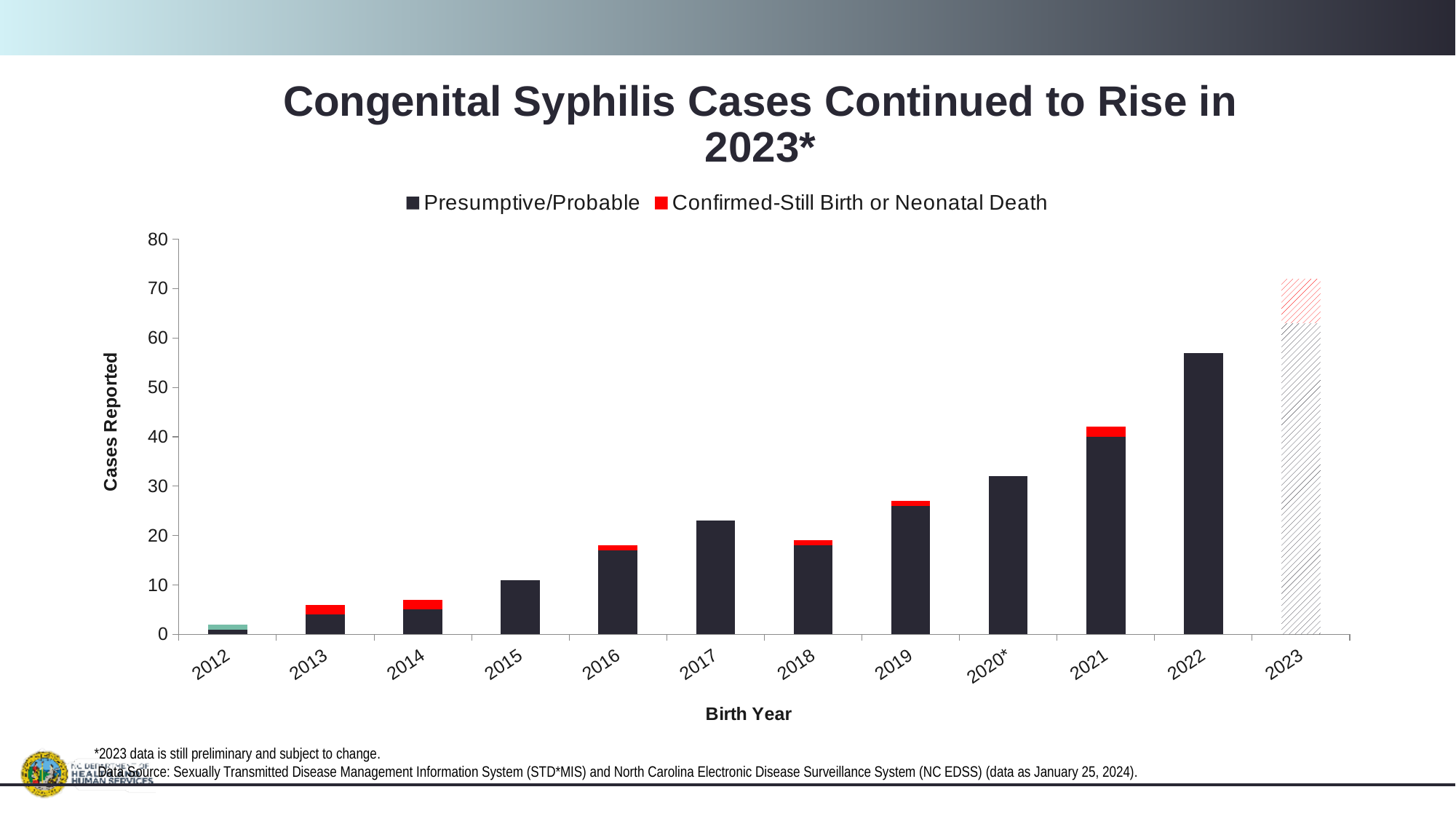
Is the total for birth year 2023 greater or less than 60? greater Which birth year has the highest total number of cases reported? 2023 How many series does the chart legend list? 2 What is the label of the y axis of the chart? Cases Reported Which birth year has the lowest total number of cases reported? 2012 Is the total for birth year 2021 greater or less than 50? less Do the cases reported generally rise or fall from 2012 to 2023? rise What kind of chart is shown on the slide? bar chart Is the total for birth year 2022 greater or less than 50? greater Which birth year has more cases reported, 2021 or 2022? 2022 How many birth years are shown on the x axis of the chart? 12